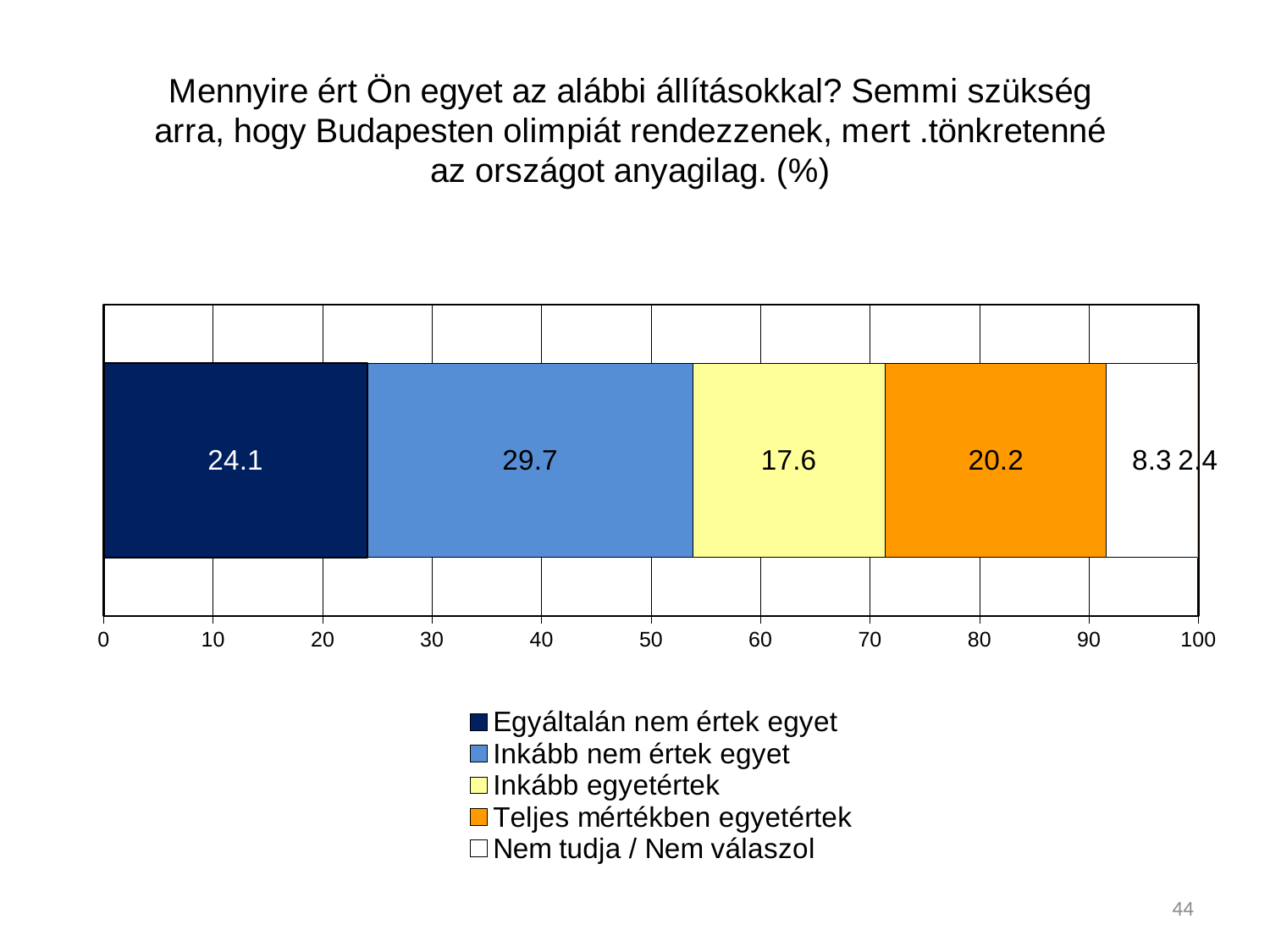
How many entries does the legend list? 5 What is the difference between "Inkább nem értek egyet" and "Egyáltalán nem értek egyet"? 5.6 What is the difference between "Teljes mértékben egyetértek" and "Inkább egyetértek"? 2.6 What is the value for "Nem tudja / Nem válaszol"? 8.3 What is the value for "Inkább nem értek egyet"? 29.7 What is the value for "Inkább egyetértek"? 17.6 What is the value for "Teljes mértékben egyetértek"? 20.2 What is the value for "Egyáltalán nem értek egyet"? 24.1 Which is larger, "Teljes mértékben egyetértek" or "Inkább egyetértek"? Teljes mértékben egyetértek Among the four agreement categories (excluding "Nem tudja / Nem válaszol"), which has the lowest value? Inkább egyetértek What kind of chart is shown on the slide? Stacked horizontal bar chart Which legend category has the highest value? Inkább nem értek egyet